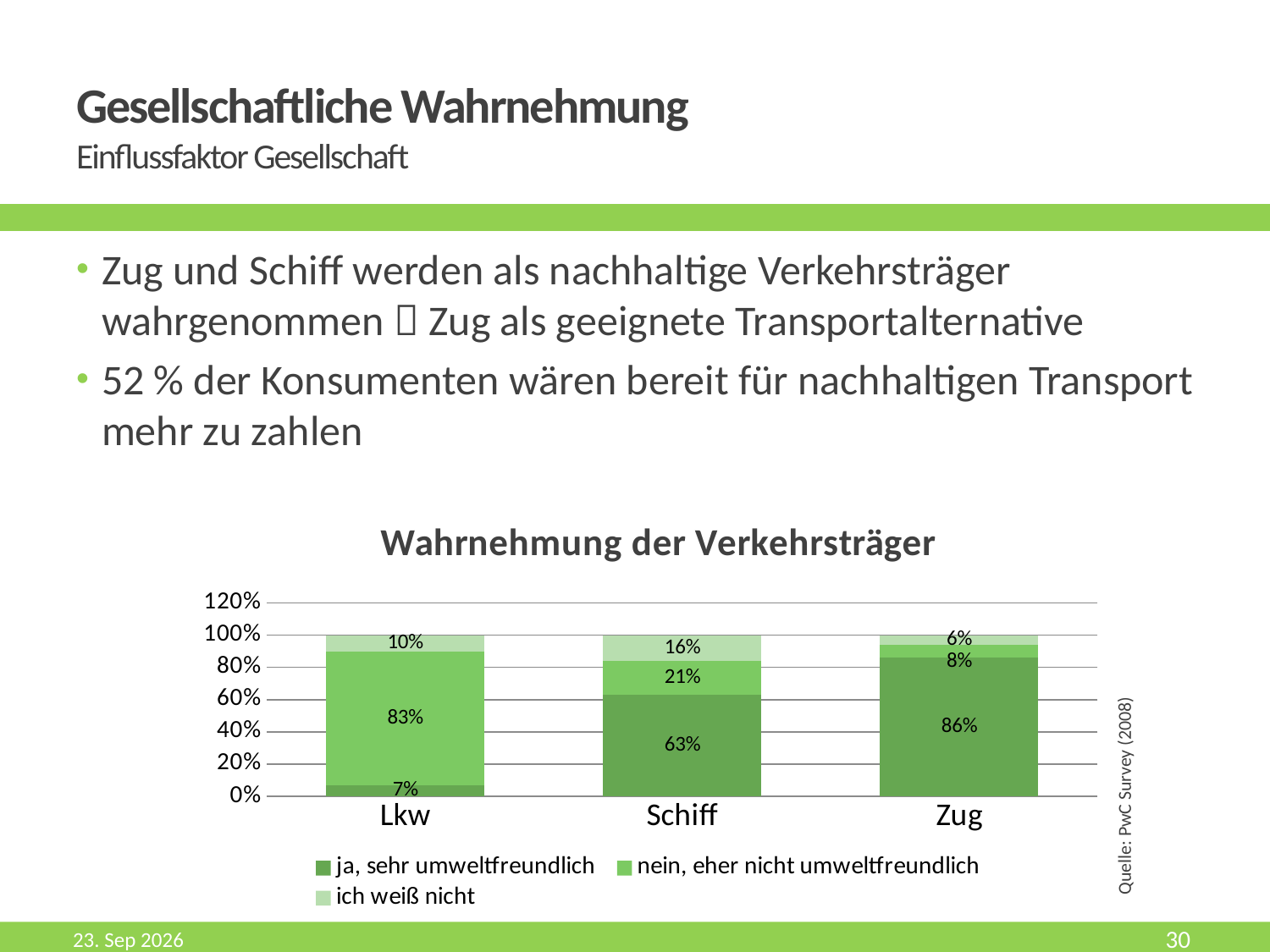
Which category has the highest value for "ja, sehr umweltfreundlich"? Zug What is the value of "ja, sehr umweltfreundlich" for Zug? 86% How many series does the legend list? 3 What is the value of "nein, eher nicht umweltfreundlich" for Lkw? 83% What is the total of the stacked bar for Schiff? 100% How many categories are shown on the x axis? 3 What type of chart is shown under the title "Wahrnehmung der Verkehrsträger"? stacked bar chart What is the value of "ich weiß nicht" for Schiff? 16% Which category has the lowest value for "ich weiß nicht"? Zug What is the difference between the "ja, sehr umweltfreundlich" values for Zug and Schiff? 23% Which is larger: the "nein, eher nicht umweltfreundlich" value for Schiff or for Zug? Schiff What is the value of "ja, sehr umweltfreundlich" for Lkw? 7%